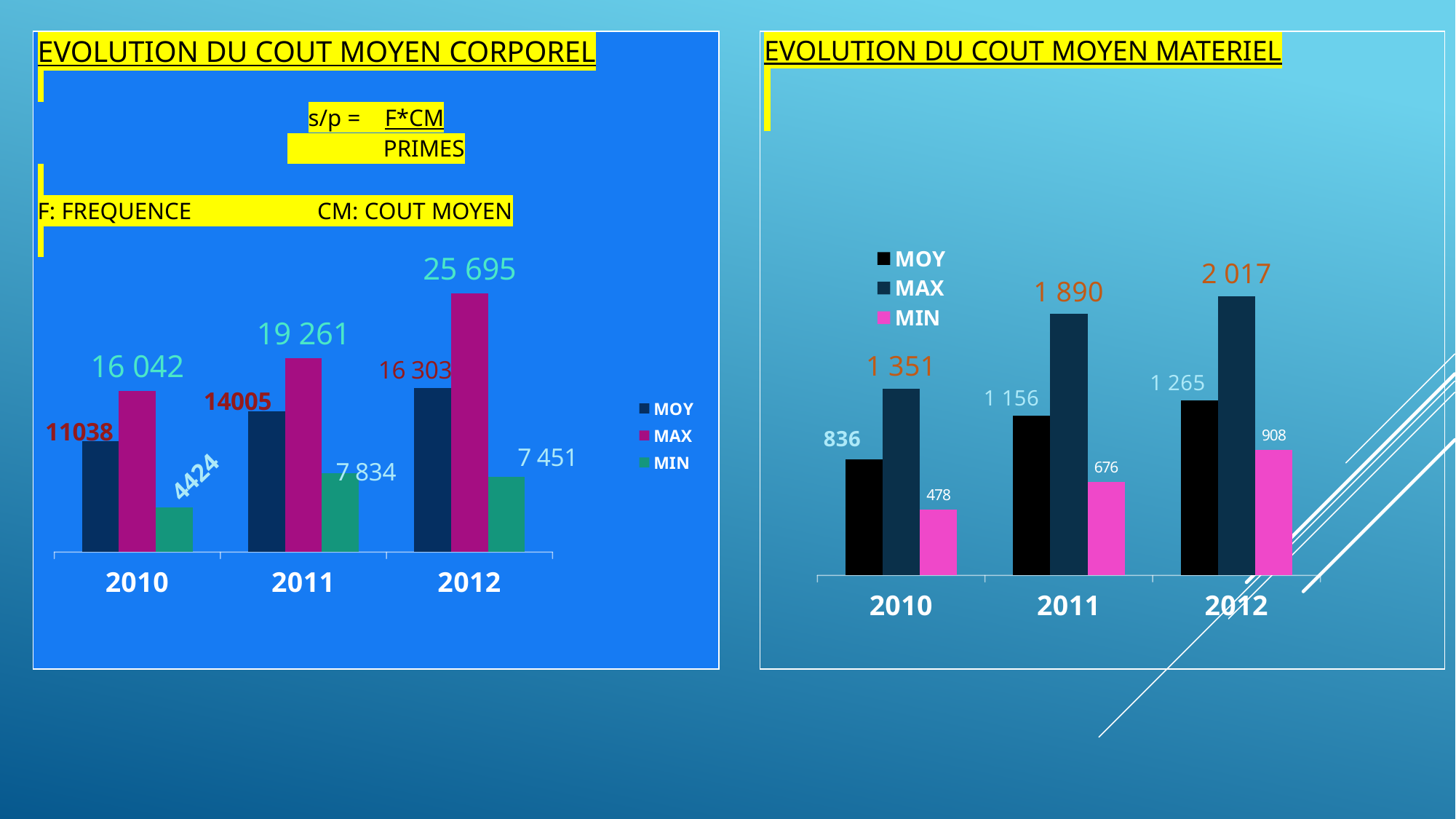
In the 'EVOLUTION DU COUT MOYEN CORPOREL' chart, what is the difference between the MAX and MOY values for 2010? 5004 In the 'EVOLUTION DU COUT MOYEN MATERIEL' chart, what is the MIN value for 2012? 908 In the 'EVOLUTION DU COUT MOYEN CORPOREL' chart, which year has the highest MAX value? 2012 In the 'EVOLUTION DU COUT MOYEN CORPOREL' chart, what is the MAX value for 2012? 25 695 What kind of chart is the 'EVOLUTION DU COUT MOYEN CORPOREL' chart? bar chart How many series does the legend of the 'EVOLUTION DU COUT MOYEN MATERIEL' chart list? 3 In the 'EVOLUTION DU COUT MOYEN MATERIEL' chart, which year has the lowest MOY value? 2010 In the 'EVOLUTION DU COUT MOYEN CORPOREL' chart, what is the MOY value for 2011? 14005 In the 'EVOLUTION DU COUT MOYEN CORPOREL' chart, does the MOY value rise or fall from 2010 to 2012? rise In the 'EVOLUTION DU COUT MOYEN MATERIEL' chart, is the MIN value for 2011 larger or smaller than the MIN value for 2010? larger In the 'EVOLUTION DU COUT MOYEN MATERIEL' chart, what is the MAX value for 2011? 1 890 In the 'EVOLUTION DU COUT MOYEN CORPOREL' chart, what is the MIN value for 2010? 4424